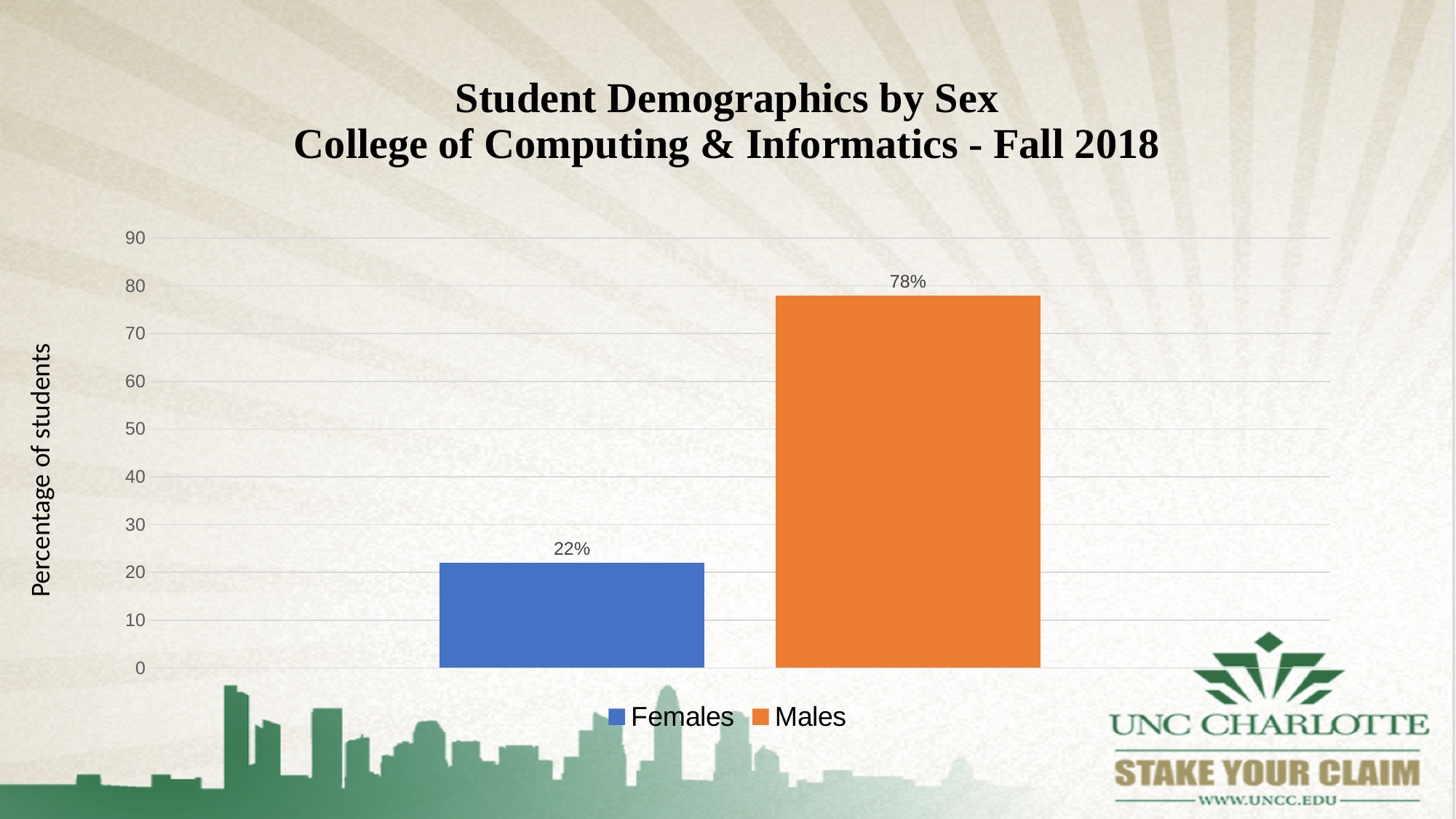
Is the value for Females greater or less than 30? less Which group has the lower percentage of students? Females Is the value for Males greater or less than 70? greater Which group has the higher percentage of students? Males What percentage of students are Males? 78% What is the difference in percentage points between Males and Females? 56 What kind of chart is shown on the slide? bar chart What percentage of students are Females? 22% What colour is the bar for Males? orange How many series does the legend list? 2 What is the label of the vertical axis? Percentage of students Is the value for Females larger or smaller than the value for Males? smaller